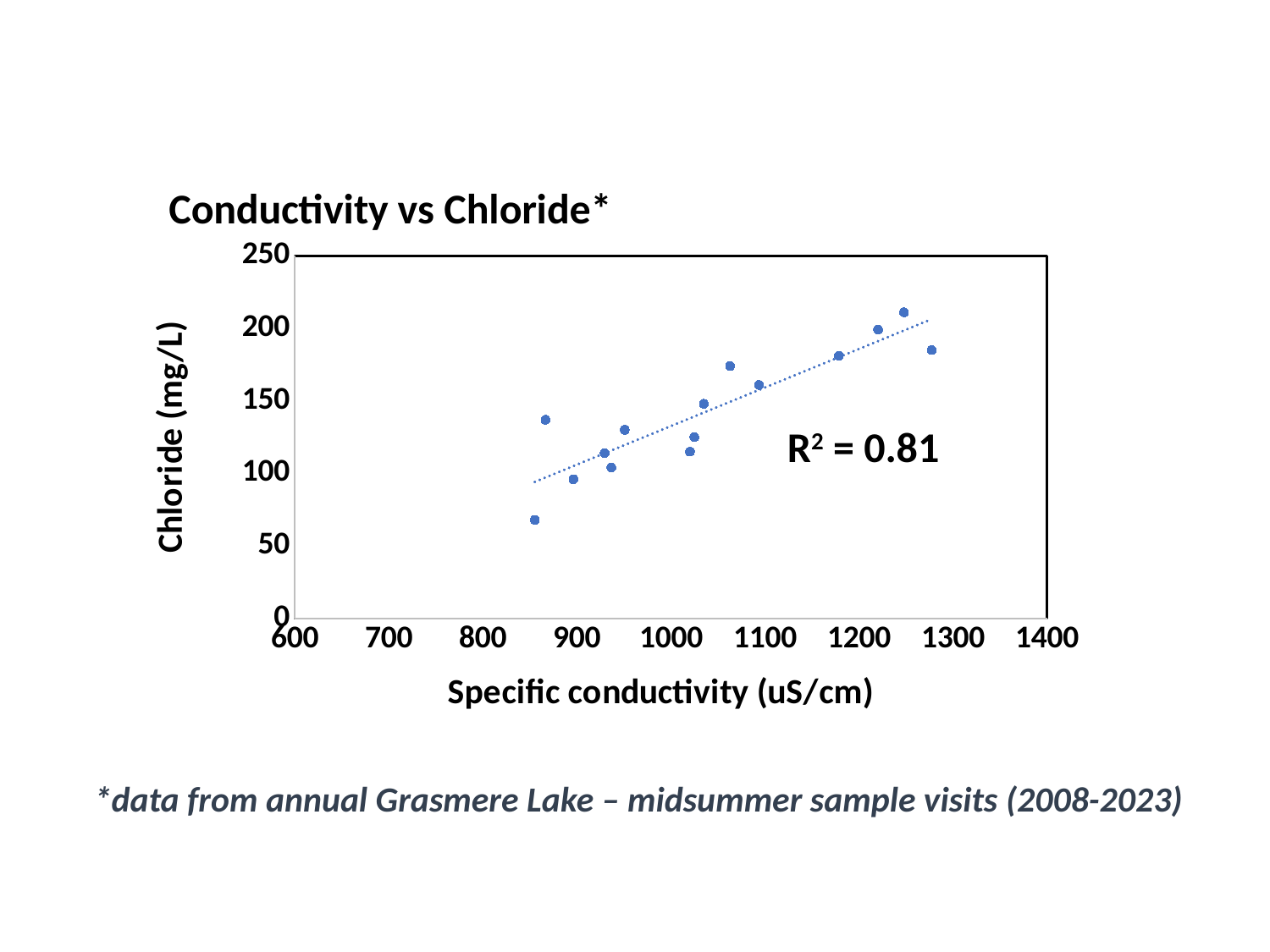
How many data points are plotted on the chart? 15 Is the specific conductivity of the point with the highest chloride greater or less than 1200 uS/cm? greater What is the maximum value shown on the y axis? 250 What is the label of the y axis? Chloride (mg/L) What R-squared value is printed on the chart? R² = 0.81 What is the maximum value shown on the x axis? 1400 Do chloride values generally rise or fall as specific conductivity increases? Rise What kind of chart is shown on the slide? Scatter plot Is the specific conductivity of the point with the lowest chloride greater or less than 900 uS/cm? less Is the highest chloride value plotted greater or less than 200 mg/L? greater What is the title of the chart? Conductivity vs Chloride*